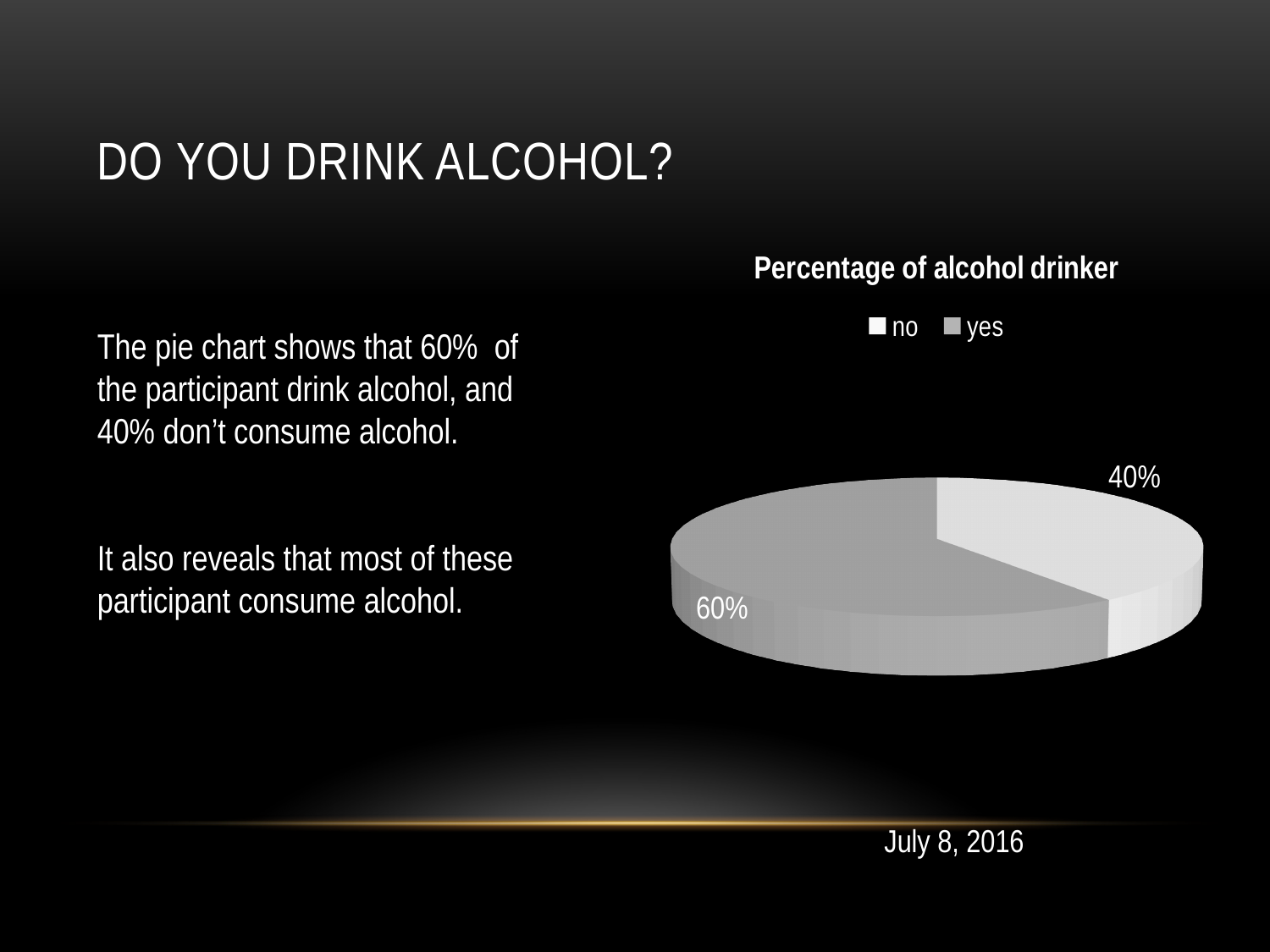
Which legend entry is shown in the lighter colour? no What percentage of the pie is labelled for the "no" slice? 40% How many slices does the pie chart have? 2 What is the difference in percentage points between the "yes" and "no" slices? 20% What is the title of the chart? Percentage of alcohol drinker Which is larger, the "yes" slice or the "no" slice? yes How many entries does the legend list? 2 What percentage of the pie is labelled for the "yes" slice? 60% What type of chart is shown on the slide? pie chart What share of the pie does the "yes" slice represent? 60% Which slice of the pie is the largest? yes Which slice of the pie is the smallest? no